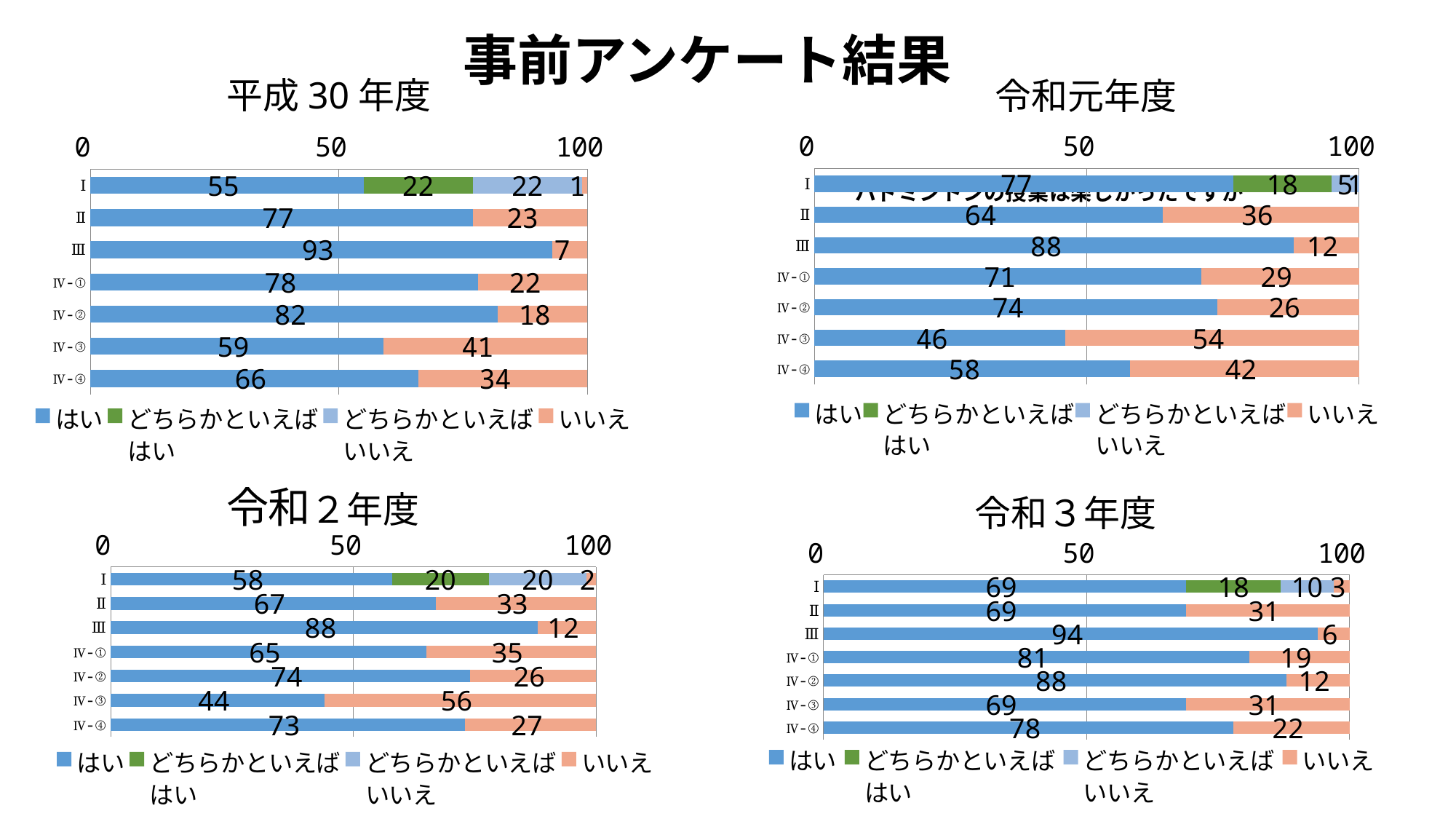
In the 令和３年度 chart, which category has the highest はい value? Ⅲ In the 令和３年度 chart, what is the difference between the はい values for Ⅳ-② and Ⅳ-①? 7 What kind of chart is the 平成30年度 chart? Stacked bar chart In the 令和元年度 chart, which is larger: the はい value for Ⅱ or for Ⅳ-①? Ⅳ-① What is the title of the chart at the bottom right of the slide? 令和３年度 In the 令和元年度 chart, what is the いいえ value for category Ⅳ-③? 54 In the 令和２年度 chart, what is the どちらかといえばいいえ value for category Ⅰ? 20 How many categories are shown on the y axis of the 令和２年度 chart? 7 In the 平成30年度 chart, what is the はい value for category Ⅲ? 93 In the 令和２年度 chart, which category has the lowest はい value? Ⅳ-③ How many series does the legend of the 令和３年度 chart list? 4 In the 平成30年度 chart, what is the total of the stacked bar for category Ⅰ? 100